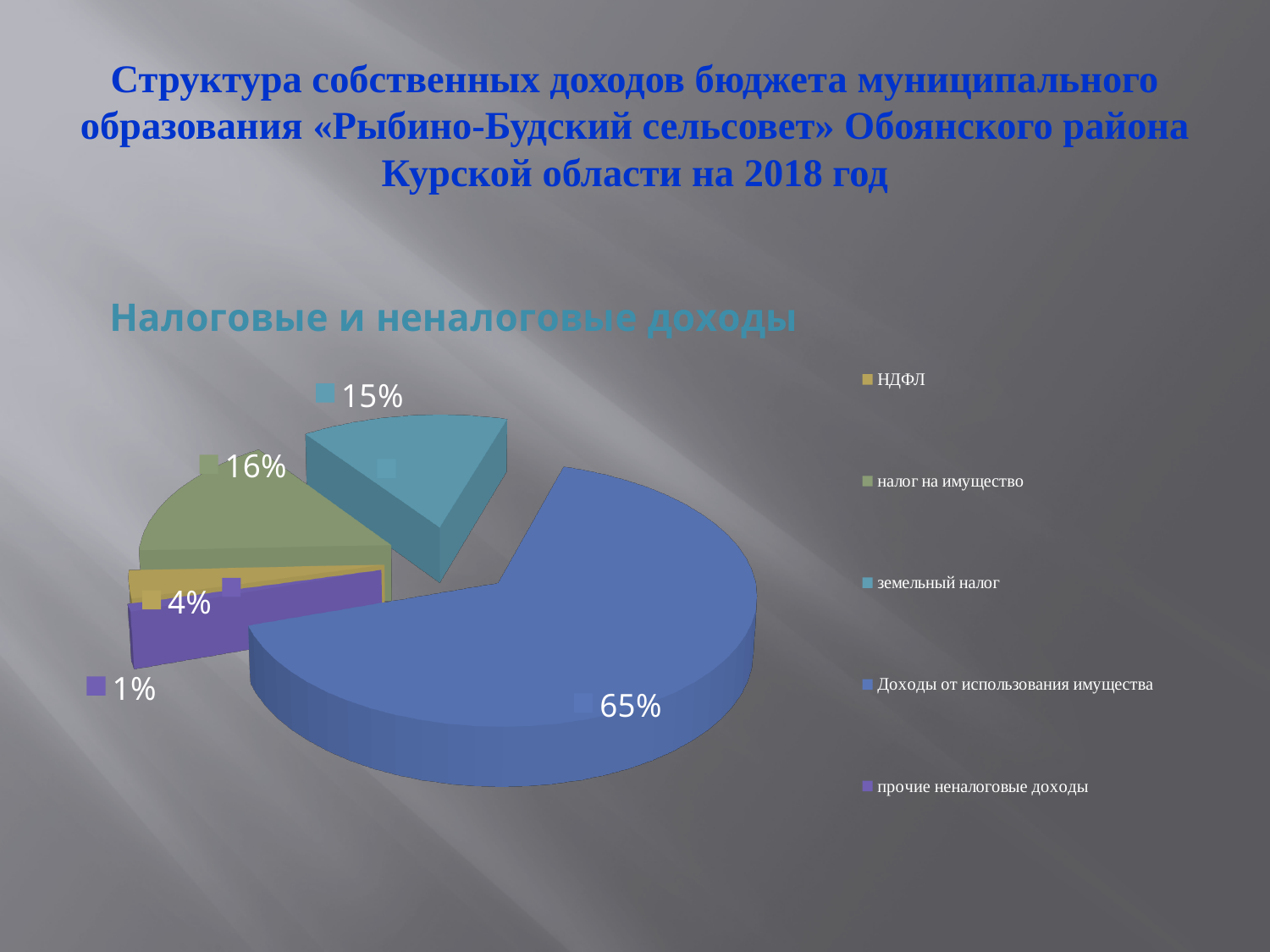
What share of the pie is налог на имущество? 16% What share of the pie is Доходы от использования имущества? 65% What share of the pie is земельный налог? 15% What kind of chart is shown on the slide? pie chart Which is larger, the share of НДФЛ or the share of земельный налог? земельный налог How many categories does the legend of the pie chart list? 5 Which category has the smallest share of the pie? прочие неналоговые доходы Which category has the largest share of the pie? Доходы от использования имущества What is the difference between the shares of Доходы от использования имущества and налог на имущество? 49% What is the title of the chart? Налоговые и неналоговые доходы